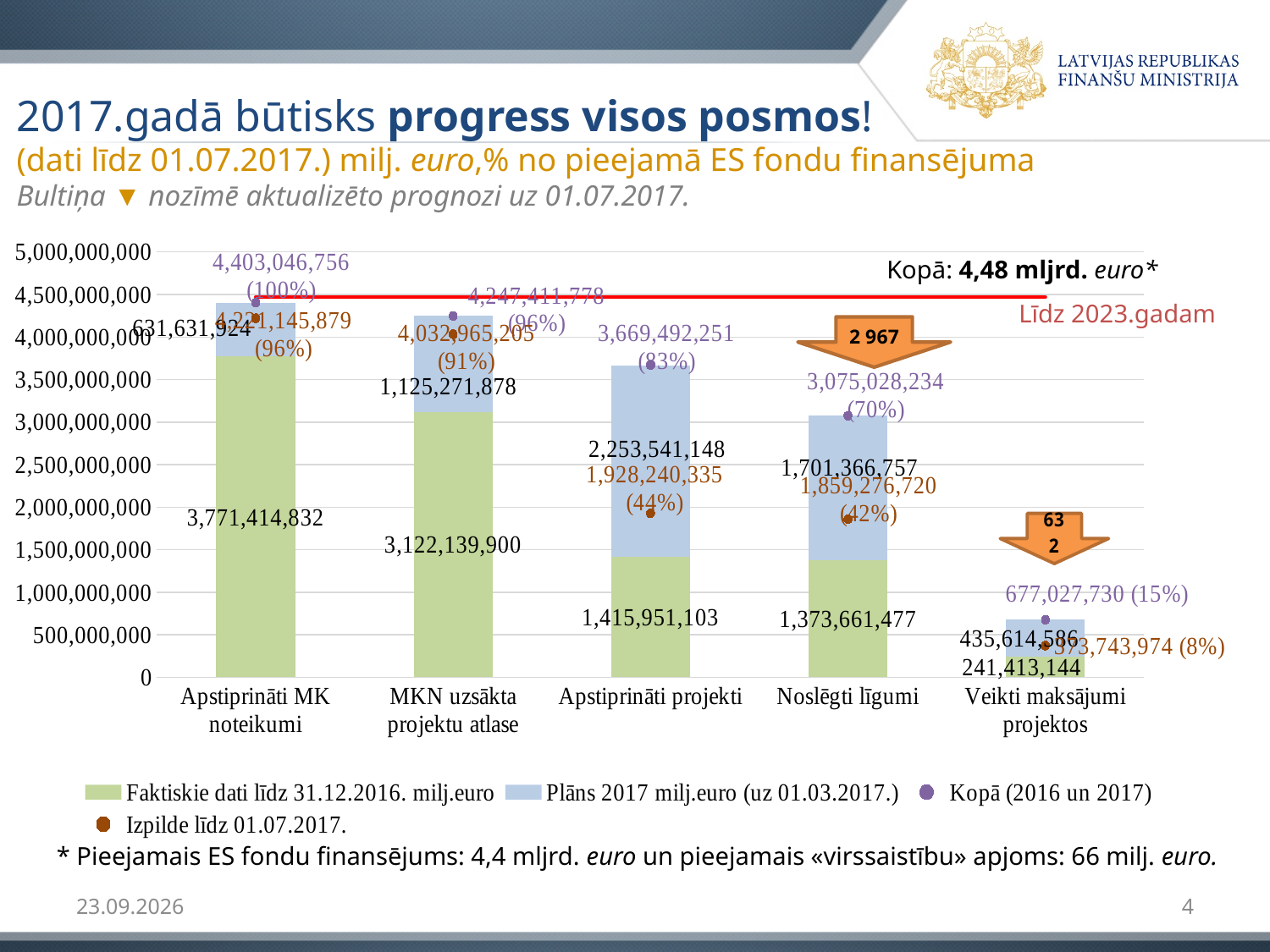
What is the 'Kopā (2016 un 2017)' value for 'Noslēgti līgumi'? 3,075,028,234 Which category has the lowest 'Kopā (2016 un 2017)' value? Veikti maksājumi projektos What percentage is shown for 'Izpilde līdz 01.07.2017.' for 'Veikti maksājumi projektos'? 8% What is the value of 'Faktiskie dati līdz 31.12.2016.' for 'Apstiprināti projekti'? 1,415,951,103 What kind of chart is shown on the slide? Stacked bar chart What is the difference between the 'Kopā (2016 un 2017)' values for 'Apstiprināti projekti' and 'Noslēgti līgumi'? 594,464,017 Which category has the highest 'Faktiskie dati līdz 31.12.2016.' value? Apstiprināti MK noteikumi How many categories are shown on the x axis? 5 Which has the larger 'Plāns 2017' value: 'Apstiprināti projekti' or 'Noslēgti līgumi'? Apstiprināti projekti Do the 'Kopā (2016 un 2017)' values rise or fall from left to right along the x axis? Fall What is the 'Plāns 2017' value for 'MKN uzsākta projektu atlase'? 1,125,271,878 How many series does the legend list? 4